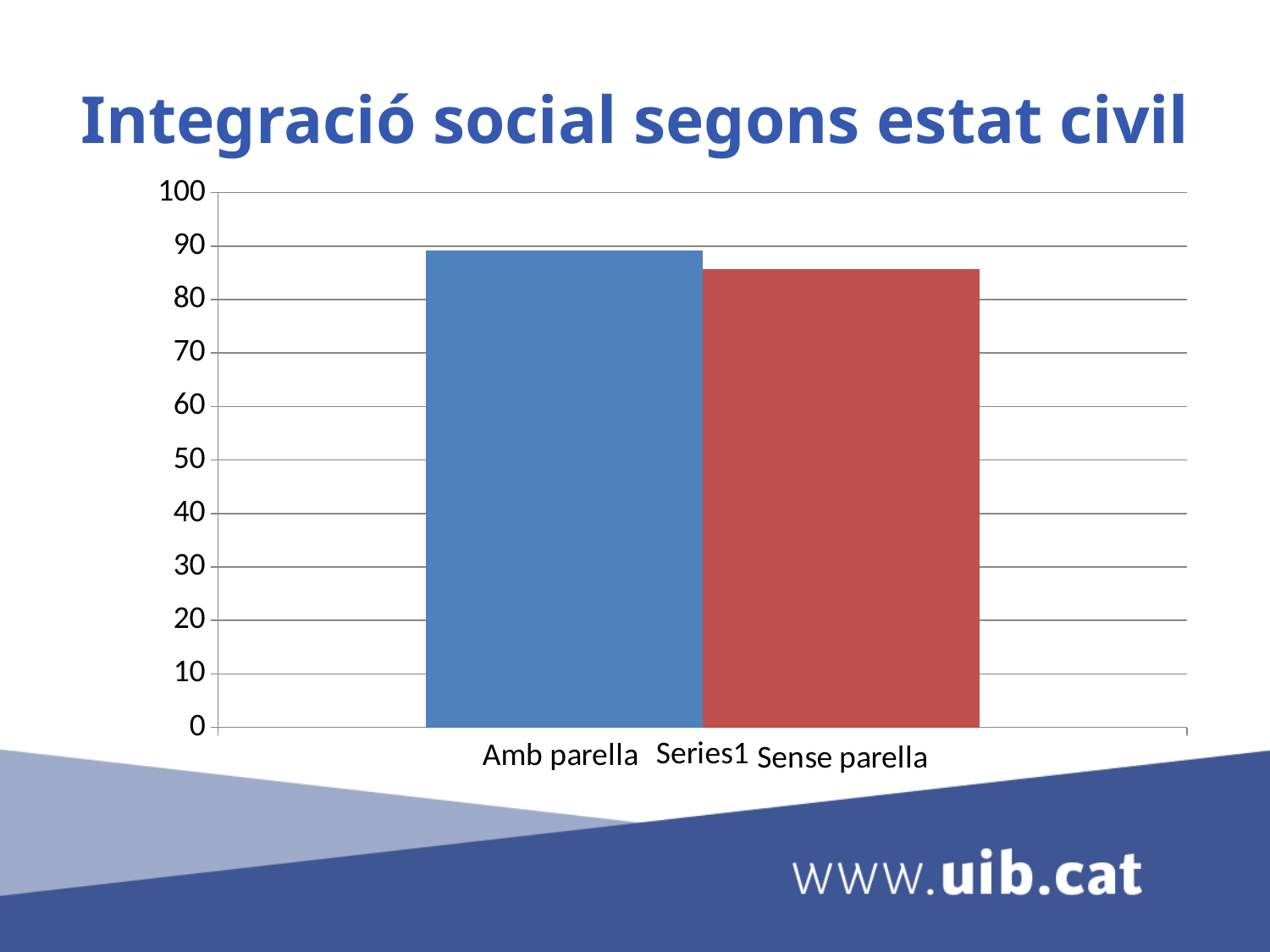
What is the maximum value shown on the vertical axis? 100 Which is larger, the value for Amb parella or the value for Sense parella? Amb parella Is the value for Amb parella greater or less than 50? greater Is the value for Sense parella greater or less than 90? less What is the title of the chart? Integració social segons estat civil How many bars are plotted in the chart? 2 Is the value for Sense parella greater or less than 80? greater What colour is the bar for Sense parella? red Which bar is the highest in the chart? Amb parella What type of chart is shown on the slide? bar chart Which bar is the lowest in the chart? Sense parella